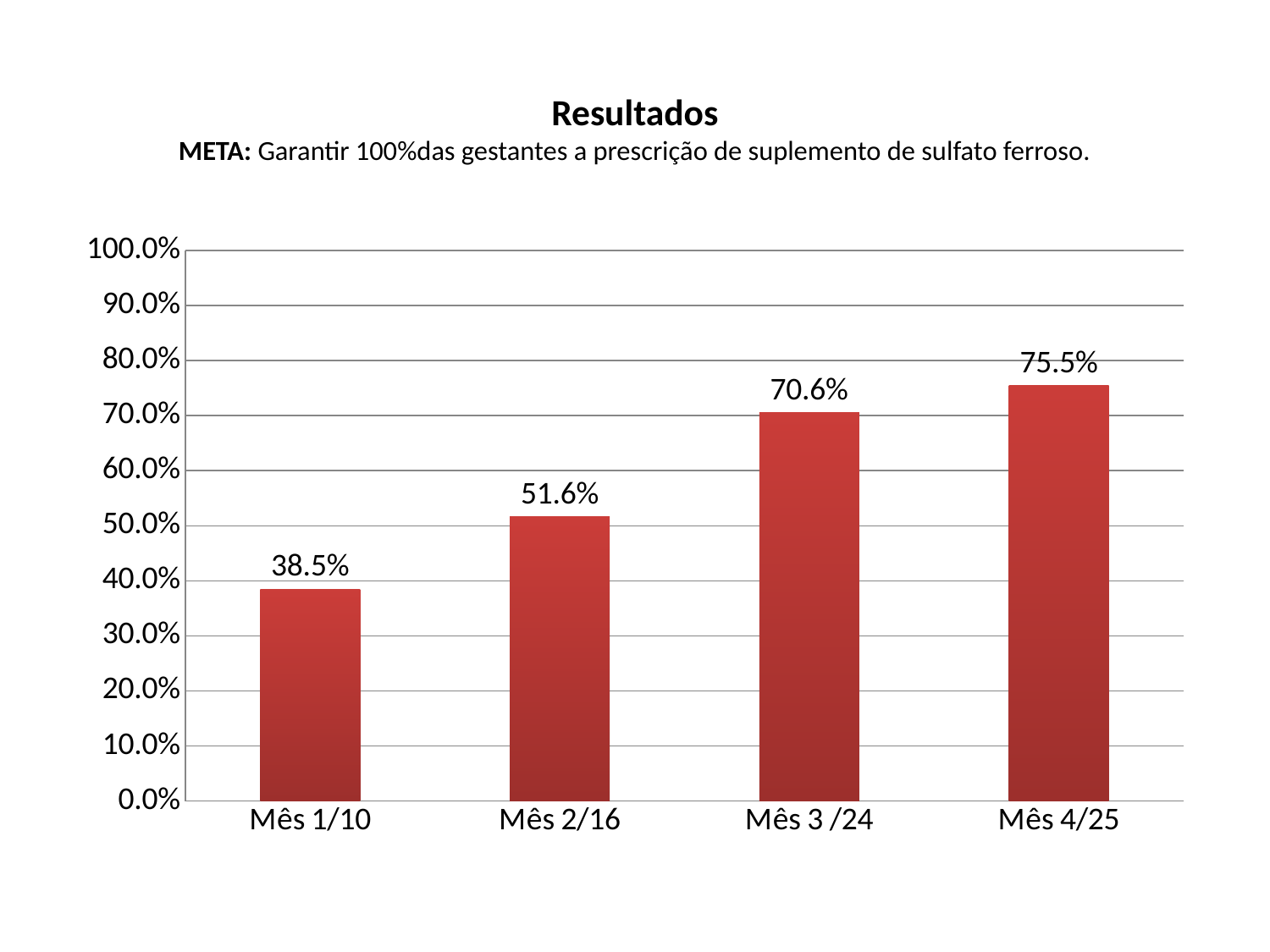
What is the value for Mês 4/25? 75.5% How many categories are shown on the x axis? 4 What is the value for Mês 3 /24? 70.6% What is the value for Mês 1/10? 38.5% Do the values rise or fall from Mês 1/10 to Mês 4/25? rise Which is larger, the value for Mês 2/16 or the value for Mês 3 /24? Mês 3 /24 What kind of chart is shown on the slide? bar chart Is the value for Mês 2/16 greater or less than 50.0%? greater Which category has the highest value? Mês 4/25 What is the difference between the values for Mês 4/25 and Mês 1/10? 37.0% Which category has the lowest value? Mês 1/10 What is the value for Mês 2/16? 51.6%